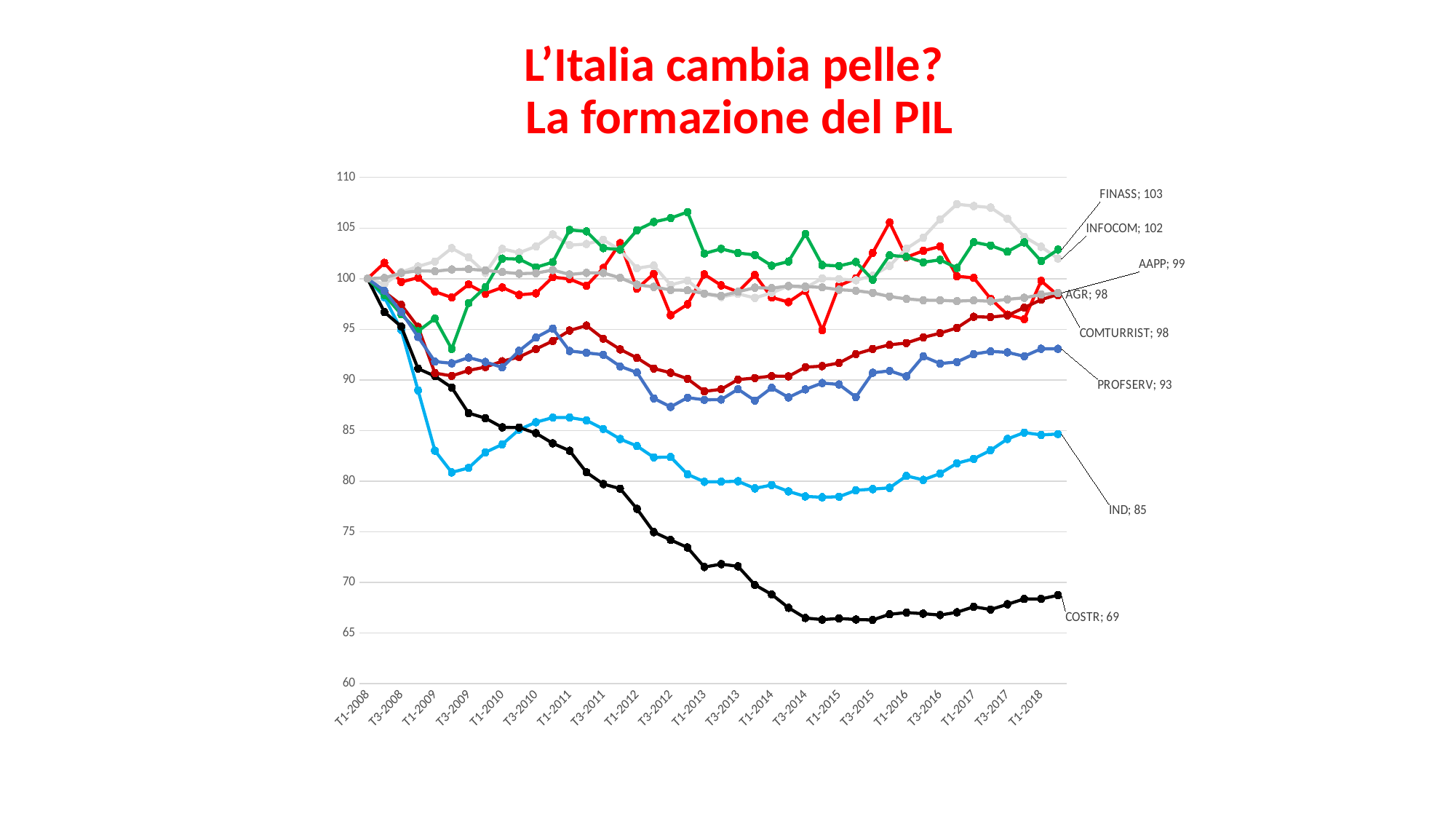
Which series has the lowest final value labelled on the chart? COSTR Which series has the highest final value labelled on the chart? FINASS What kind of chart is shown on the slide? line chart Is the value for COSTR at T1-2015 greater or less than 70? less What is the final value shown for the PROFSERV series? 93 Does the COSTR series rise or fall overall from T1-2008 to T1-2018? fall Which has a higher final value, INFOCOM or AAPP? INFOCOM How many series are labelled on the chart? 8 What is the final value shown for the FINASS series? 103 What is the final value shown for the COSTR series? 69 What is the final value shown for the IND series? 85 What is the difference between the final values of FINASS and COSTR? 34